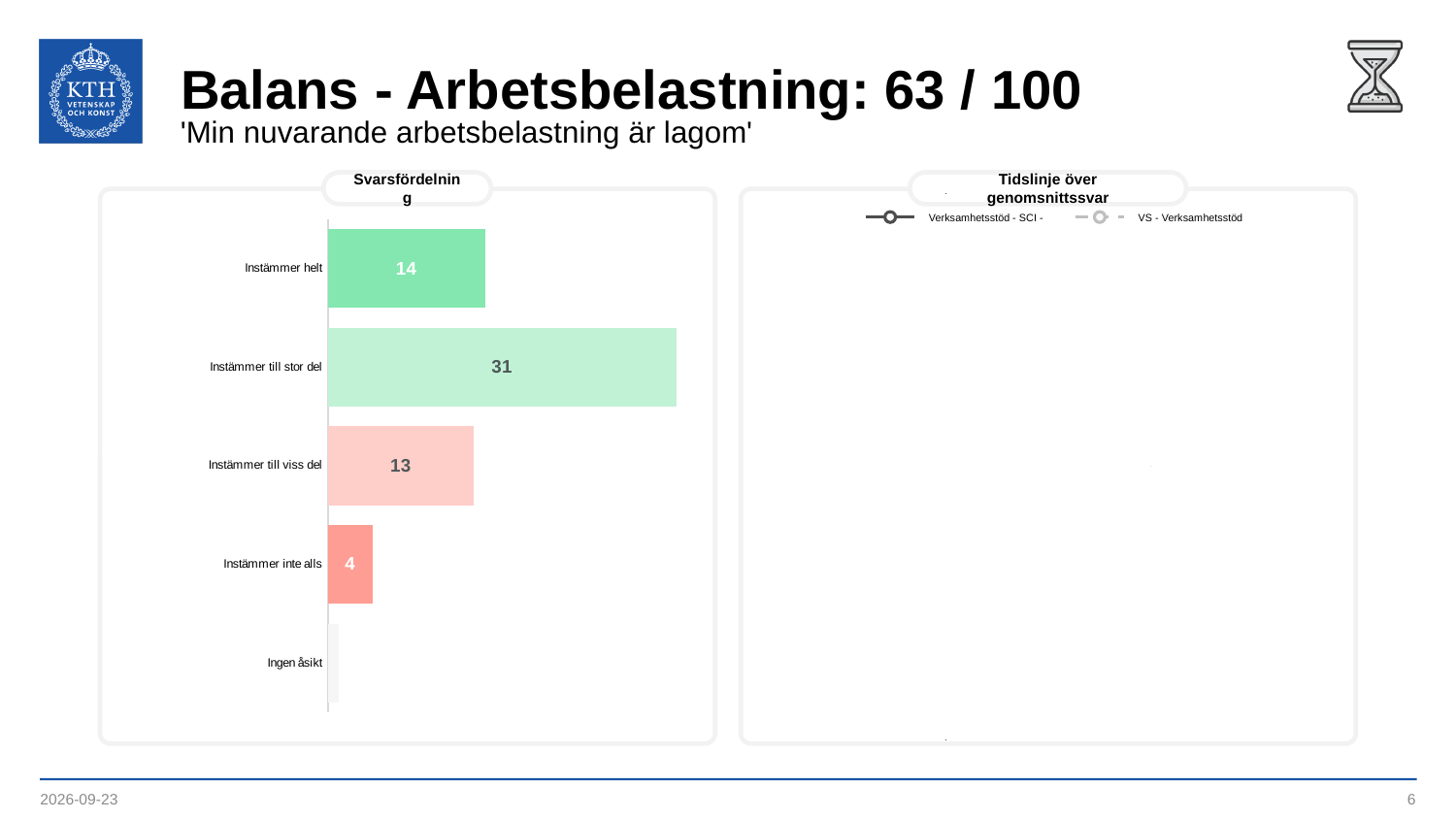
In the Svarsfördelning chart, which category has the highest value? Instämmer till stor del What is the title of the chart on the left side of the slide? Svarsfördelning How many categories are shown in the Svarsfördelning chart? 5 What kind of chart is the Svarsfördelning chart? Bar chart In the Svarsfördelning chart, what is the difference between Instämmer till stor del and Instämmer helt? 17 In the Svarsfördelning chart, what is the value for Instämmer inte alls? 4 In the Svarsfördelning chart, which labelled category has the lowest value? Instämmer inte alls In the Svarsfördelning chart, what is the value for Instämmer till stor del? 31 How many series does the legend of the Tidslinje över genomsnittssvar chart list? 2 In the Svarsfördelning chart, what is the value for Instämmer helt? 14 In the Svarsfördelning chart, which is larger: Instämmer till viss del or Instämmer inte alls? Instämmer till viss del In the Svarsfördelning chart, what is the value for Instämmer till viss del? 13